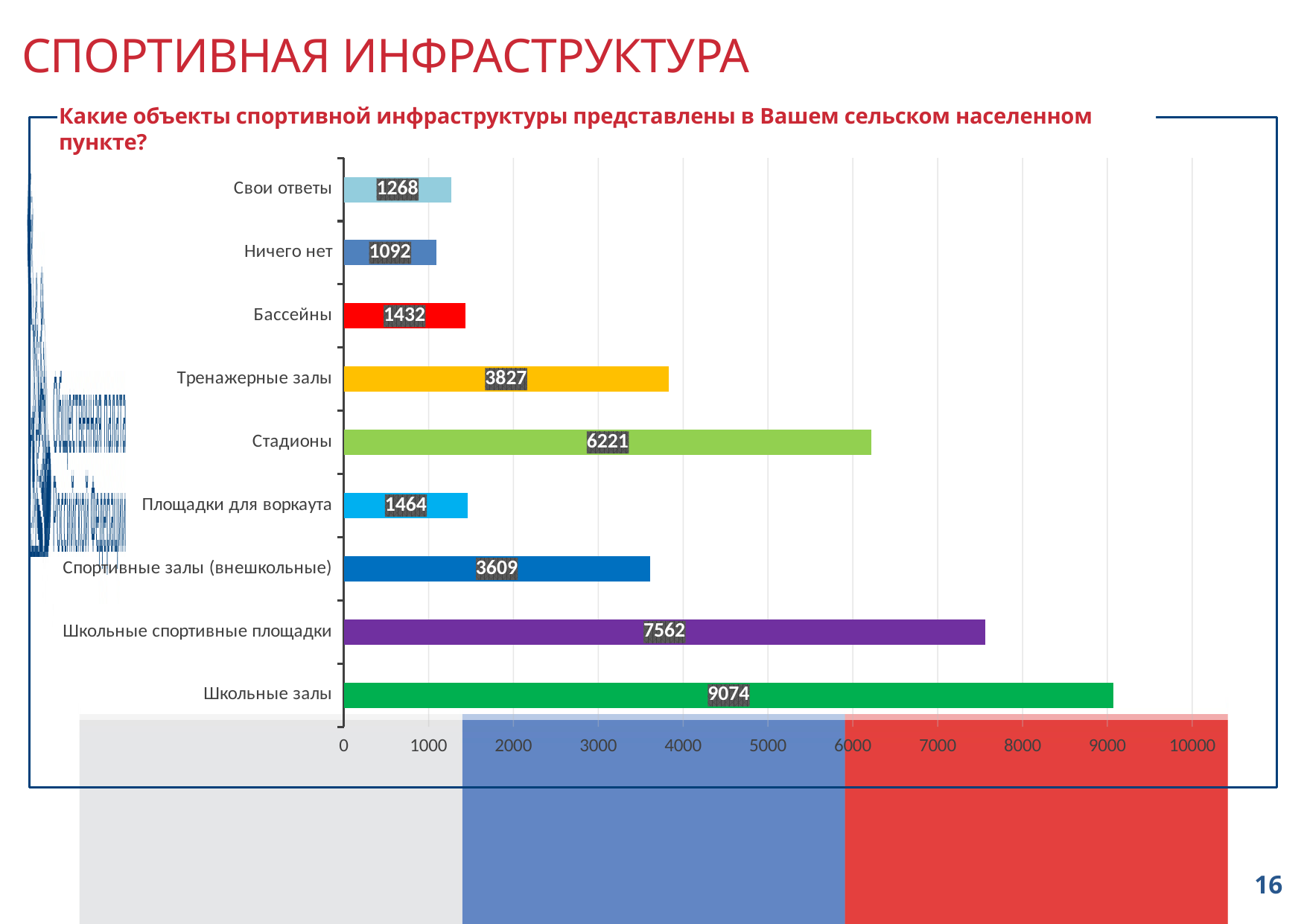
What is the difference between Площадки для воркаута and Свои ответы? 196 What is the difference between Школьные спортивные площадки and Спортивные залы (внешкольные)? 3953 What is the maximum value shown on the x axis? 10000 What kind of chart is shown on the slide? bar chart Which category has the lowest value? Ничего нет What is the value for Школьные залы? 9074 Which is larger: Тренажерные залы or Спортивные залы (внешкольные)? Тренажерные залы How many categories are shown in the chart? 9 What is the value for Бассейны? 1432 Is the value for Стадионы greater or less than 6000? greater What is the value for Стадионы? 6221 Which category has the highest value? Школьные залы